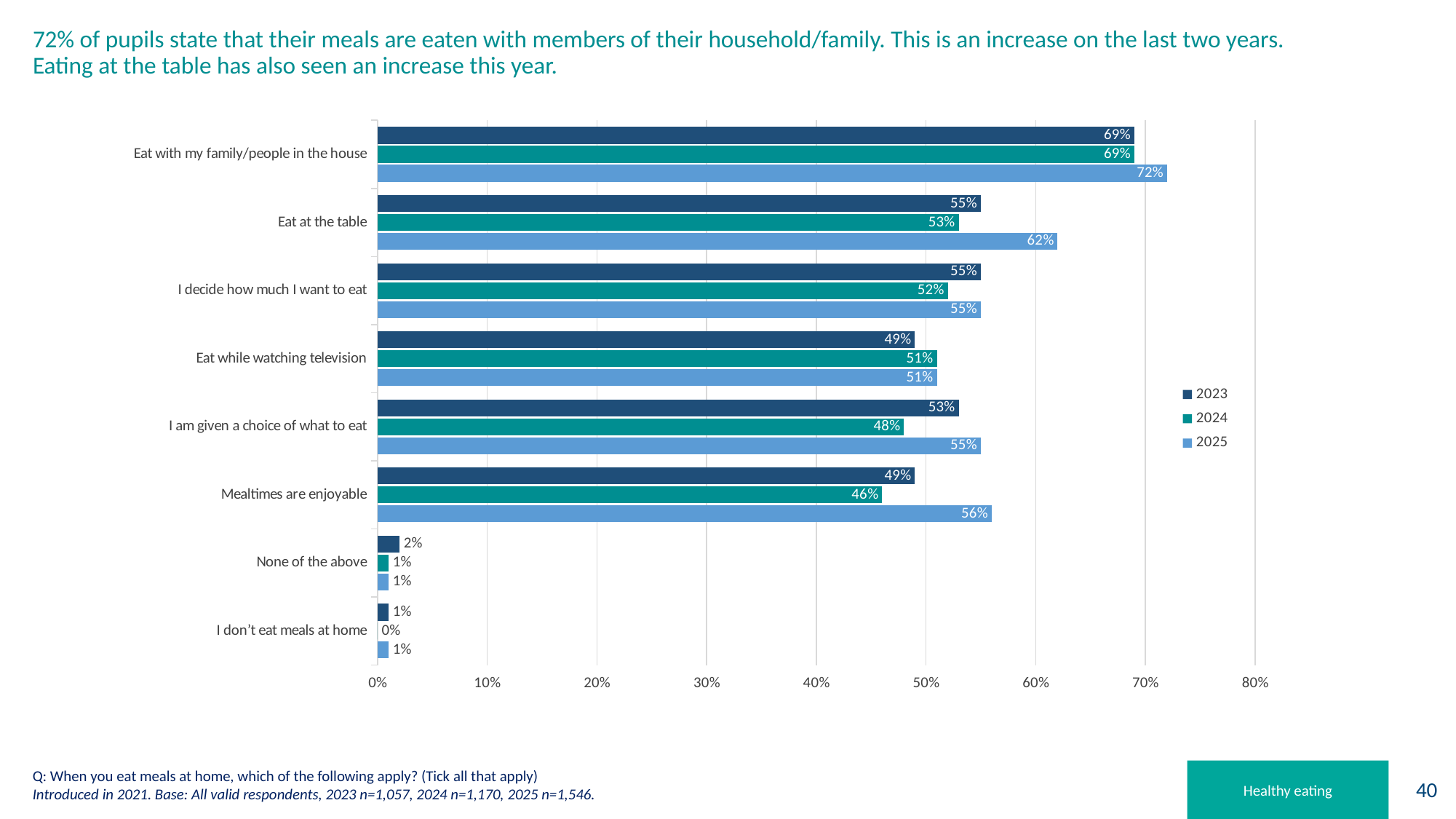
How many series does the legend list? 3 Which is larger for "Mealtimes are enjoyable": the 2023 value or the 2025 value? 2025 What is the 2025 value for "Eat at the table"? 62% What is the difference between the 2025 and 2023 values for "Eat with my family/people in the house"? 3% Which years are listed in the chart legend? 2023, 2024, 2025 How many categories are shown on the chart? 8 Which category has the highest 2025 value? Eat with my family/people in the house What is the 2023 value for "I am given a choice of what to eat"? 53% What is the difference between the 2025 and 2024 values for "Eat at the table"? 9% What kind of chart is shown on the slide? Bar chart What is the 2024 value for "Mealtimes are enjoyable"? 46% Which category has the lowest 2024 value? I don't eat meals at home